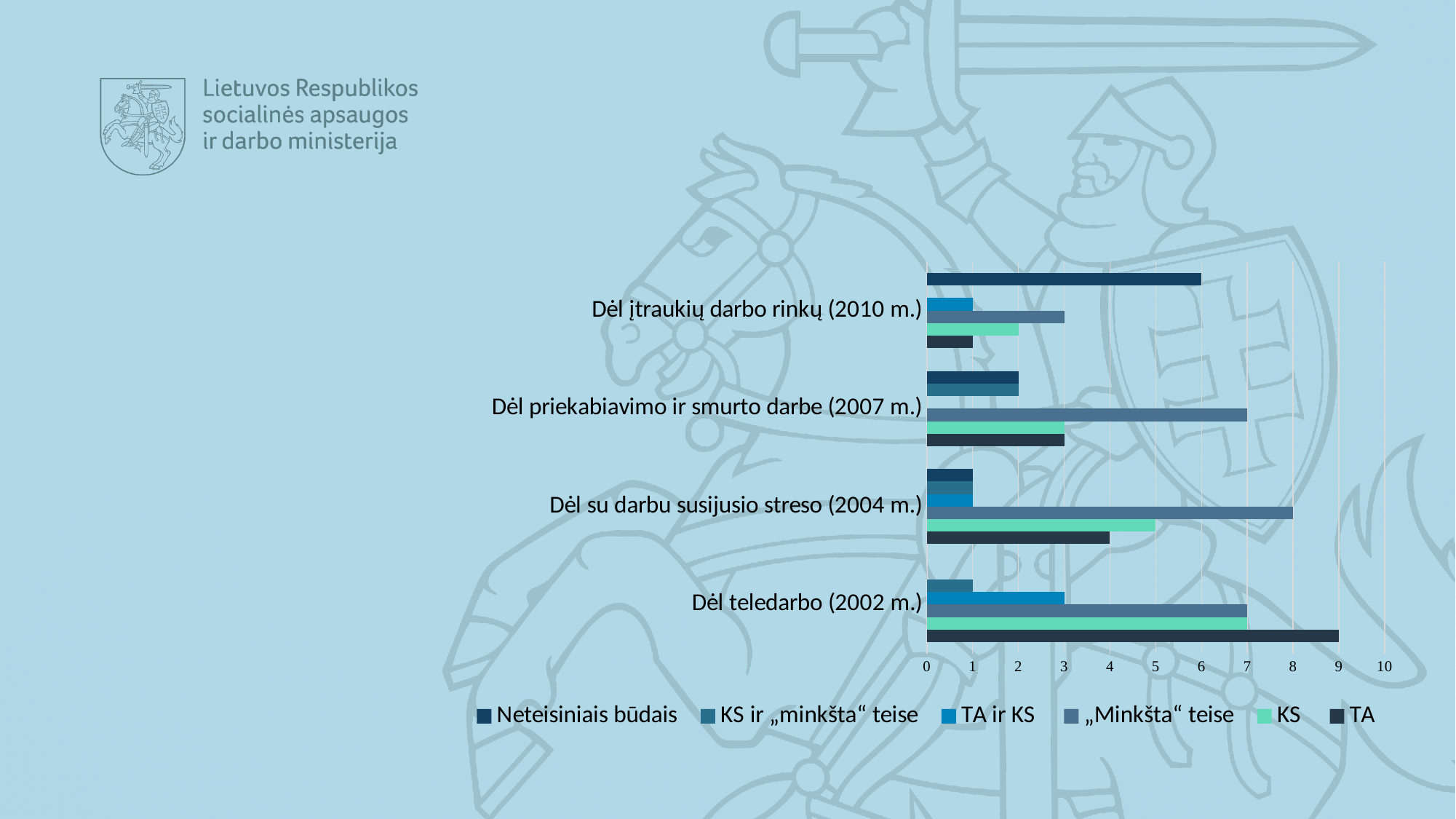
Which series has the highest value for "Dėl teledarbo (2002 m.)"? TA Is the TA value for "Dėl teledarbo (2002 m.)" greater or less than 8? greater What kind of chart is shown on the slide? bar chart What is the value of KS for "Dėl su darbu susijusio streso (2004 m.)"? 5 Which category has the highest TA value? Dėl teledarbo (2002 m.) Which is larger: the „Minkšta“ teise value for "Dėl su darbu susijusio streso (2004 m.)" or for "Dėl priekabiavimo ir smurto darbe (2007 m.)"? Dėl su darbu susijusio streso (2004 m.) How many categories are shown on the chart? 4 What is the value of „Minkšta“ teise for "Dėl su darbu susijusio streso (2004 m.)"? 8 What is the value of Neteisiniais būdais for "Dėl įtraukių darbo rinkų (2010 m.)"? 6 What is the value of TA for "Dėl teledarbo (2002 m.)"? 9 How many series does the legend list? 6 What is the difference between the TA value for "Dėl teledarbo (2002 m.)" and the TA value for "Dėl su darbu susijusio streso (2004 m.)"? 5